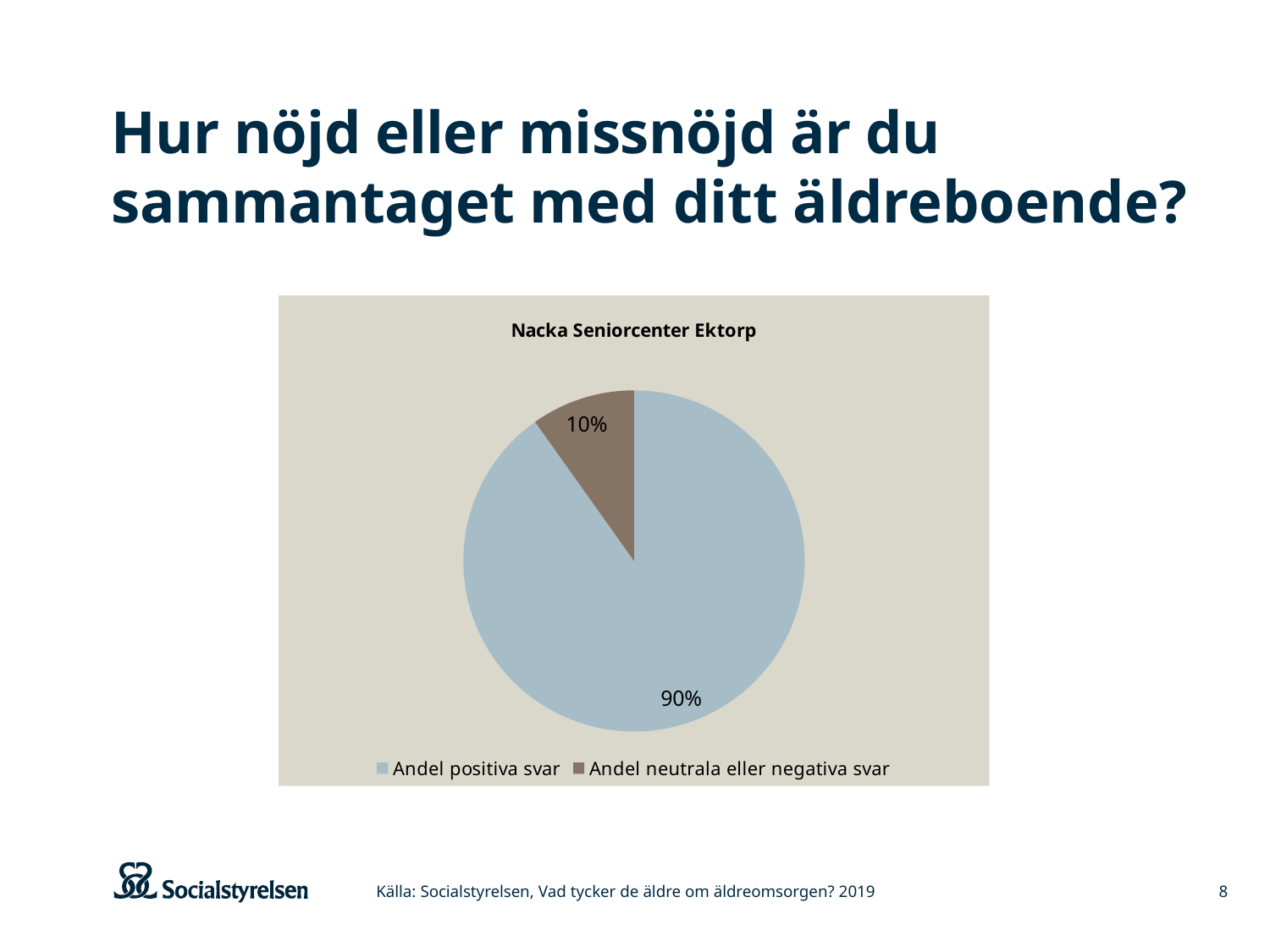
Which is larger, 'Andel positiva svar' or 'Andel neutrala eller negativa svar'? Andel positiva svar How many entries does the legend list? 2 What colour is the 'Andel neutrala eller negativa svar' slice? brown What is the difference between the 'Andel positiva svar' share and the 'Andel neutrala eller negativa svar' share? 80% Which slice is the largest? Andel positiva svar What share of the pie is 'Andel positiva svar'? 90% What is the chart's title? Nacka Seniorcenter Ektorp What share of the pie is 'Andel neutrala eller negativa svar'? 10% What kind of chart is shown on the slide? pie chart How many slices does the pie chart have? 2 Which slice is the smallest? Andel neutrala eller negativa svar